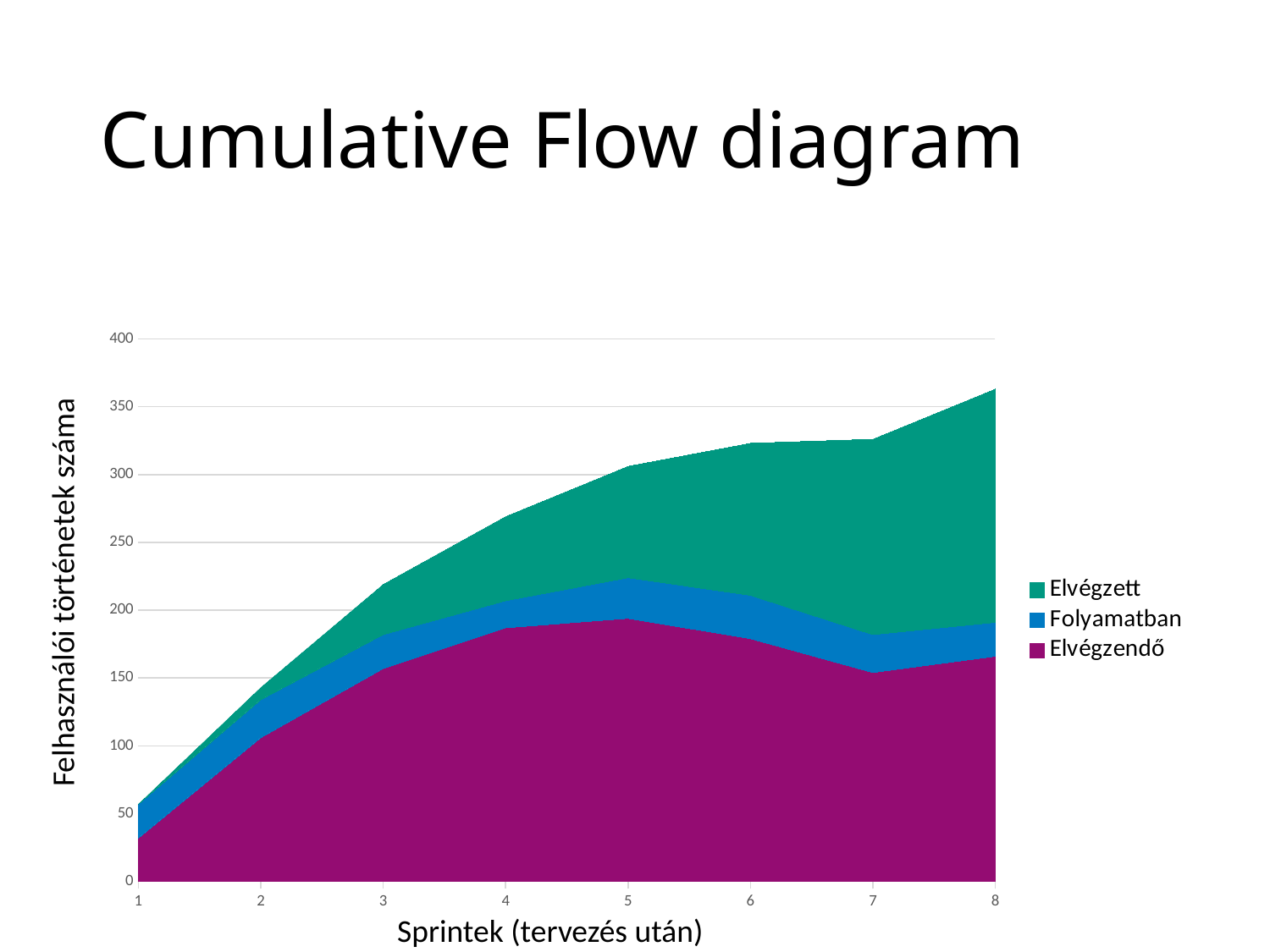
Is the value for Elvégzendő at sprint 1 greater or less than 50? less Is the total of all three series at sprint 3 greater or less than 200? greater What kind of chart is shown on the slide? Stacked area chart How many series does the legend list? 3 What is the title of the chart? Cumulative Flow diagram Does the total height of the stacked areas rise or fall from sprint 1 to sprint 8? Rise What is the label of the y axis? Felhasználói történetek száma Is the total of all three series at sprint 8 greater or less than 350? greater At which sprint is the value for Elvégzendő lowest? 1 How many sprints are plotted along the x axis? 8 At which sprint is the total of all three series highest? 8